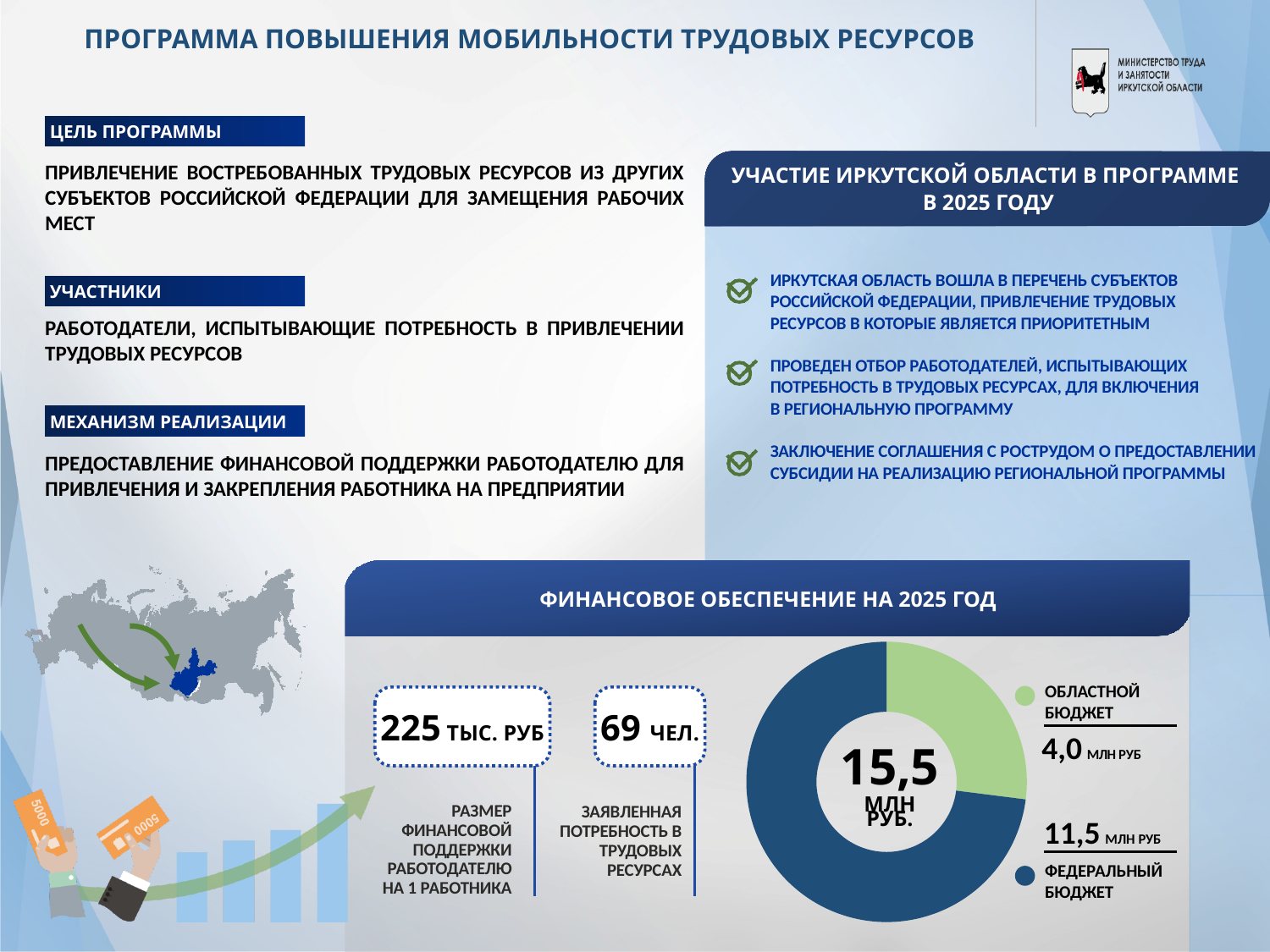
In the donut chart, what is the value for Областной бюджет? 4,0 млн руб How many slices does the donut chart have? 2 What total is shown in the centre of the donut chart? 15,5 млн руб. Which budget source is the smallest slice of the donut chart? Областной бюджет What is the title of the section containing the donut chart? Финансовое обеспечение на 2025 год Which is larger in the donut chart: Областной бюджет or Федеральный бюджет? Федеральный бюджет By how much does the Федеральный бюджет exceed the Областной бюджет in the donut chart? 7,5 млн руб What colour is the Областной бюджет slice in the donut chart? Light green Which budget source is the largest slice of the donut chart? Федеральный бюджет In the donut chart, what is the value for Федеральный бюджет? 11,5 млн руб What type of chart is shown in the 'Финансовое обеспечение на 2025 год' section? Pie (donut) chart Does the Федеральный бюджет slice account for more or less than half of the donut chart? More